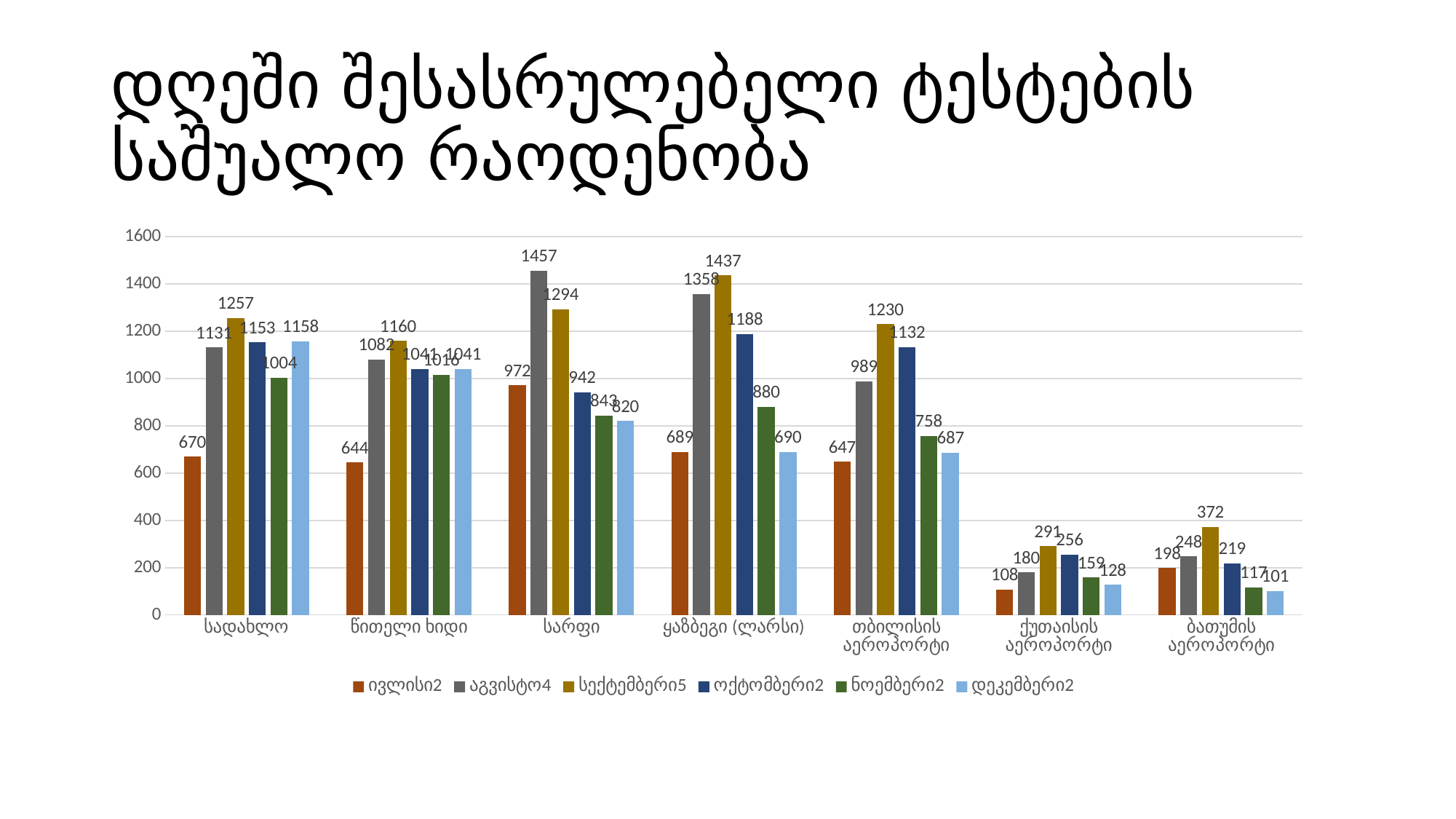
Which series has the lowest value in the ქუთაისის აეროპორტი category? ივლისი2 Is the value for ოქტომბერი2 in the სარფი category greater or less than 1000? less How many series does the legend list? 6 What is the difference between the სექტემბერი5 and ივლისი2 values in the თბილისის აეროპორტი category? 583 What is the value for სექტემბერი5 in the სადახლო category? 1257 What type of chart is shown on the slide? bar chart Which is larger in the წითელი ხიდი category: the value for აგვისტო4 or the value for ნოემბერი2? აგვისტო4 How many categories are shown on the x axis? 7 What is the title of the chart on the slide? დღეში შესასრულებელი ტესტების საშუალო რაოდენობა What is the value for დეკემბერი2 in the ბათუმის აეროპორტი category? 101 What is the value for აგვისტო4 in the სარფი category? 1457 Which series has the highest value in the ყაზბეგი (ლარსი) category? სექტემბერი5